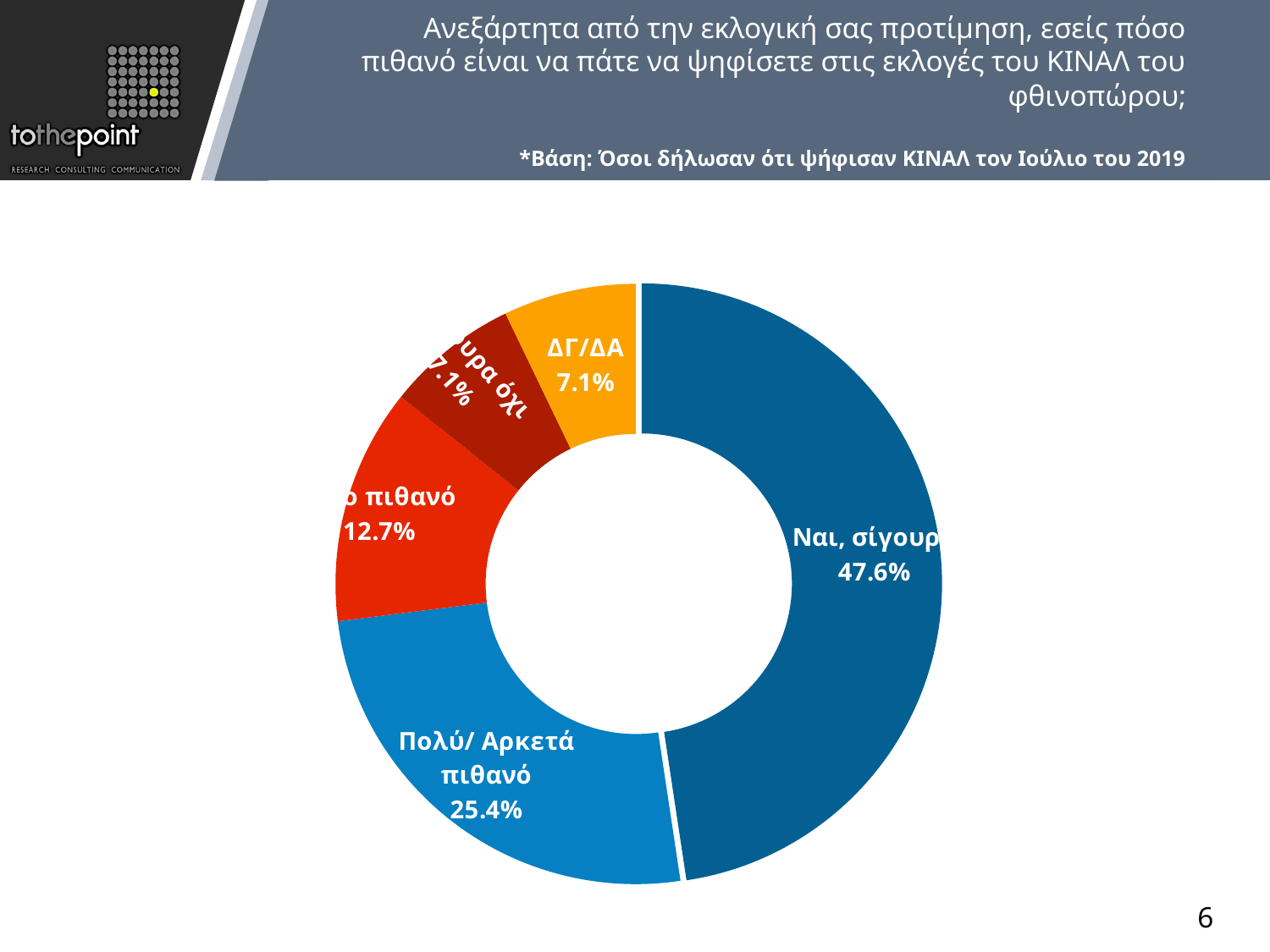
How many slices of the chart show a value of 7.1%? 2 What is the combined percentage of the "Ναι, σίγουρα" and "Πολύ/ Αρκετά πιθανό" slices? 73.0% What percentage is shown for the slice labelled "Πολύ/ Αρκετά πιθανό"? 25.4% What is the difference in percentage points between the "Ναι, σίγουρα" slice and the "Πολύ/ Αρκετά πιθανό" slice? 22.2 percentage points Which is larger, the "Πολύ/ Αρκετά πιθανό" slice or the "ΔΓ/ΔΑ" slice? Πολύ/ Αρκετά πιθανό What colour is the "ΔΓ/ΔΑ" slice? orange What percentage is shown for the slice labelled "Ναι, σίγουρα"? 47.6% What percentage is shown for the slice labelled "ΔΓ/ΔΑ"? 7.1% Which slice of the chart is the largest? Ναι, σίγουρα How many slices does the chart have? 5 What kind of chart is shown on the slide? pie chart (donut) What share of the chart does the "ΔΓ/ΔΑ" slice represent? 7.1%